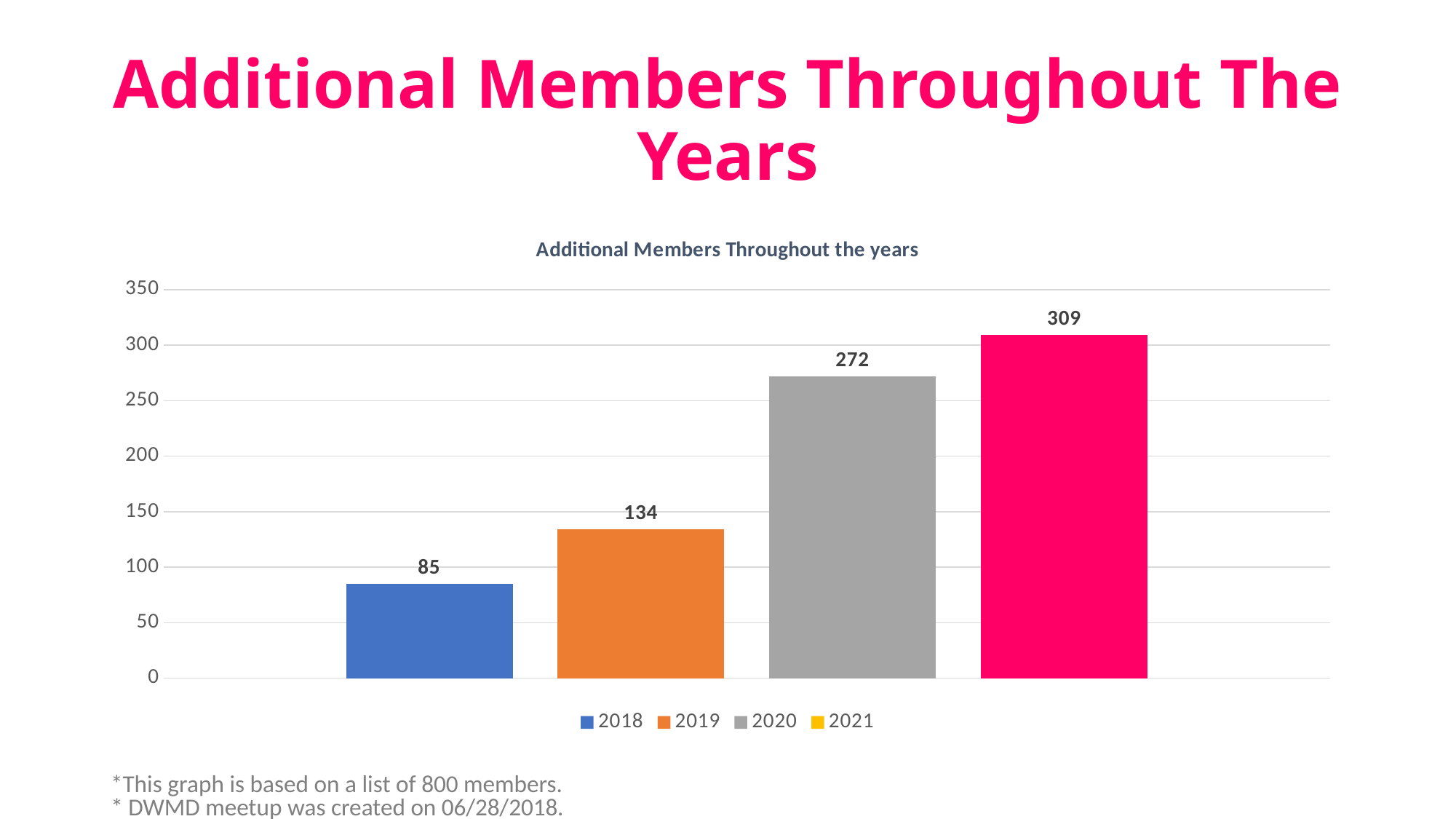
Which is larger, the value for 2019 or the value for 2020? 2020 What is the value for 2020? 272 What is the value for 2019? 134 Which year has the lowest value? 2018 Do the values rise or fall from 2018 to 2021? Rise What is the value for 2021? 309 Which year has the highest value? 2021 What is the value for 2018? 85 How many bars are plotted in the chart? 4 What kind of chart is shown on the slide? Bar chart What is the difference between the values for 2021 and 2020? 37 What is the difference between the values for 2019 and 2018? 49